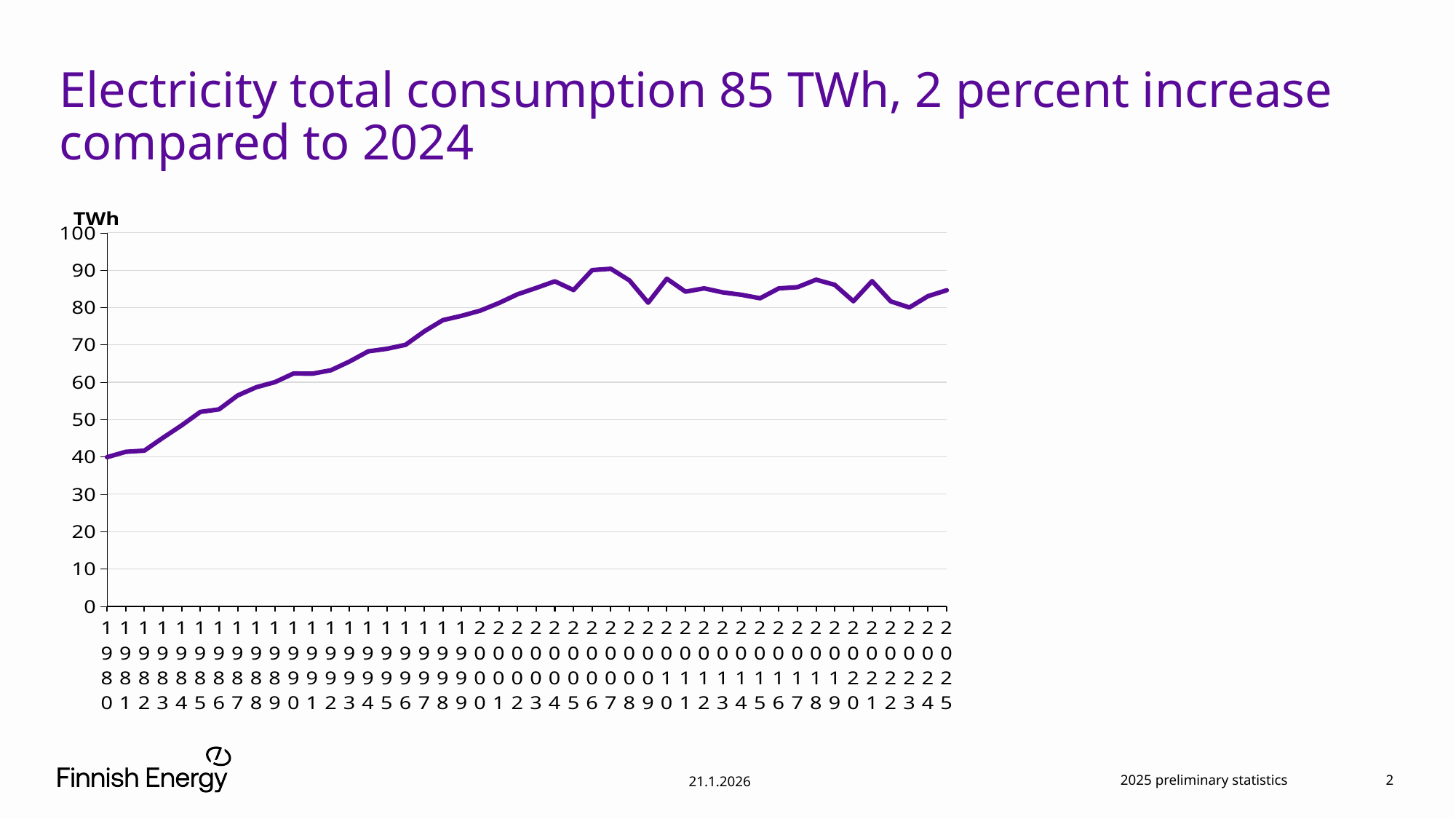
Is the value for 2000 greater or less than 70? greater How many years are plotted on the x axis of the chart? 46 What is the title of the slide containing the chart? Electricity total consumption 85 TWh, 2 percent increase compared to 2024 What kind of chart is shown on the slide? line chart How many lines are plotted on the chart? 1 Is the value for 2009 greater or less than 90? less What unit is shown on the vertical axis of the chart? TWh Overall, does electricity consumption rise or fall from 1980 to 2025? rise Which year has the larger value, 2009 or 2010? 2010 Is the value for 1980 greater or less than 50? less Which year has the lowest electricity consumption on the chart? 1980